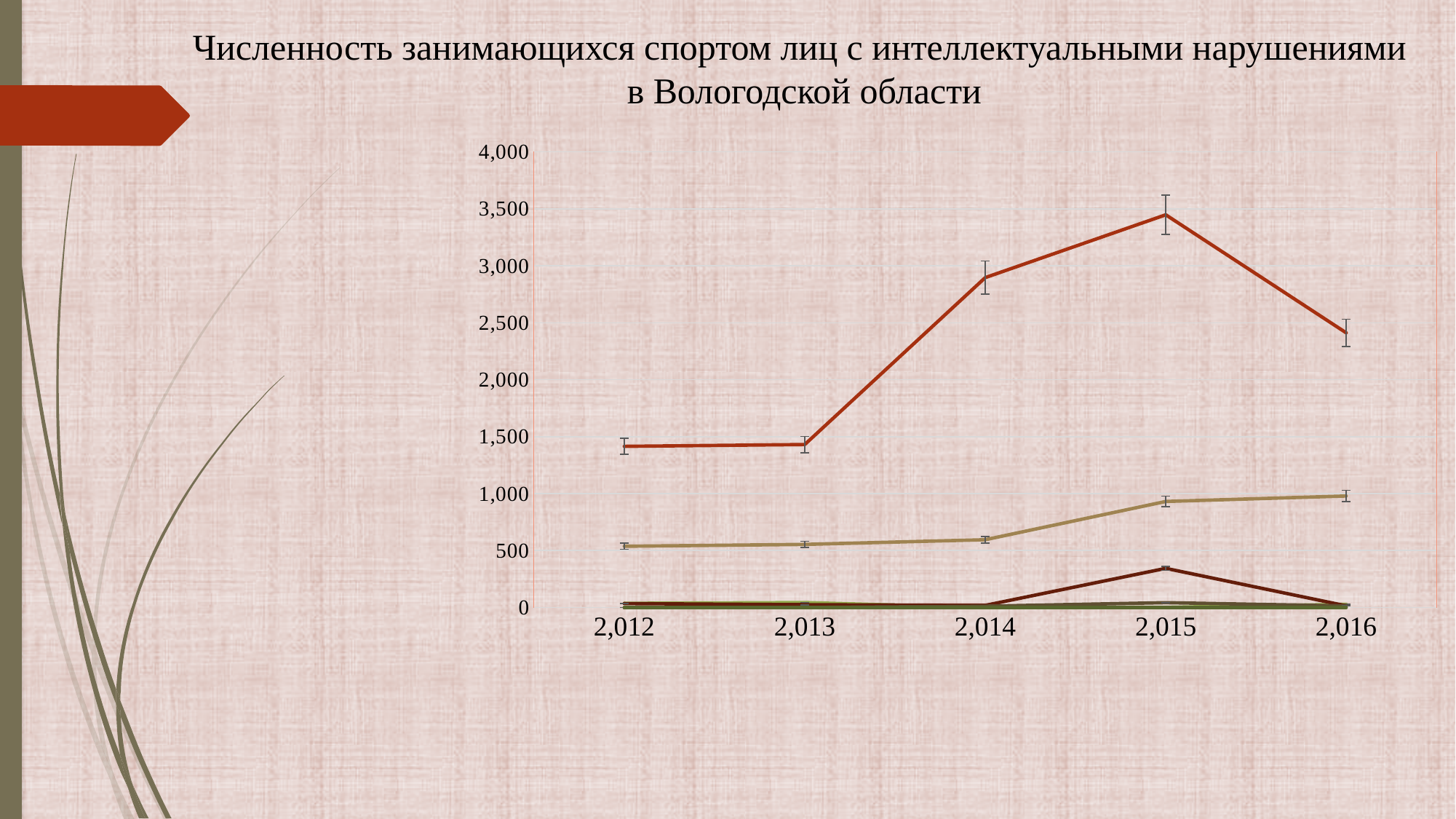
Is the value of the tan (second-highest) line in 2,015 greater or less than 500? greater What kind of chart is shown on the slide? line chart What is the first year shown on the x axis? 2,012 Is the value of the topmost (orange-red) line in 2,013 greater or less than 2,000? less For the topmost (orange-red) line, which year has the larger value: 2,014 or 2,016? 2,014 Is the value of the topmost (orange-red) line in 2,015 greater or less than 3,000? greater In which year does the topmost (orange-red) line reach its highest value? 2,015 What is the title of the chart on the slide? Численность занимающихся спортом лиц с интеллектуальными нарушениями в Вологодской области Does the topmost (orange-red) line rise or fall between 2,015 and 2,016? fall How many years are shown along the x axis of the chart? 5